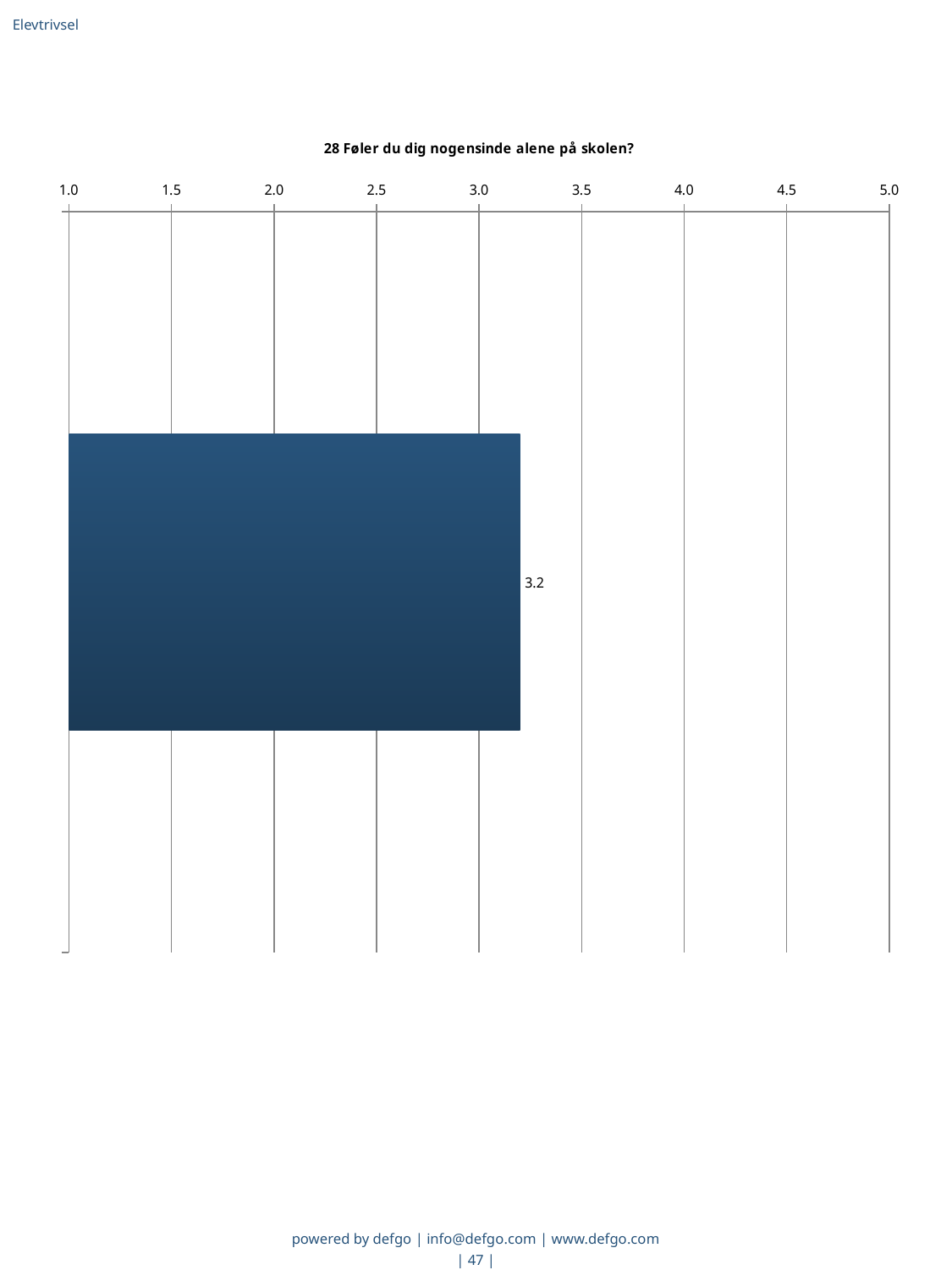
What is the value shown on the bar in the chart? 3.2 Is the value of the bar greater or less than 3.5? less Is the value of the bar greater or less than 3.0? greater What is the highest value shown on the chart's axis? 5.0 How many bars are plotted in the chart? 1 What kind of chart is shown on the slide? bar chart What is the title of the chart? 28 Føler du dig nogensinde alene på skolen?